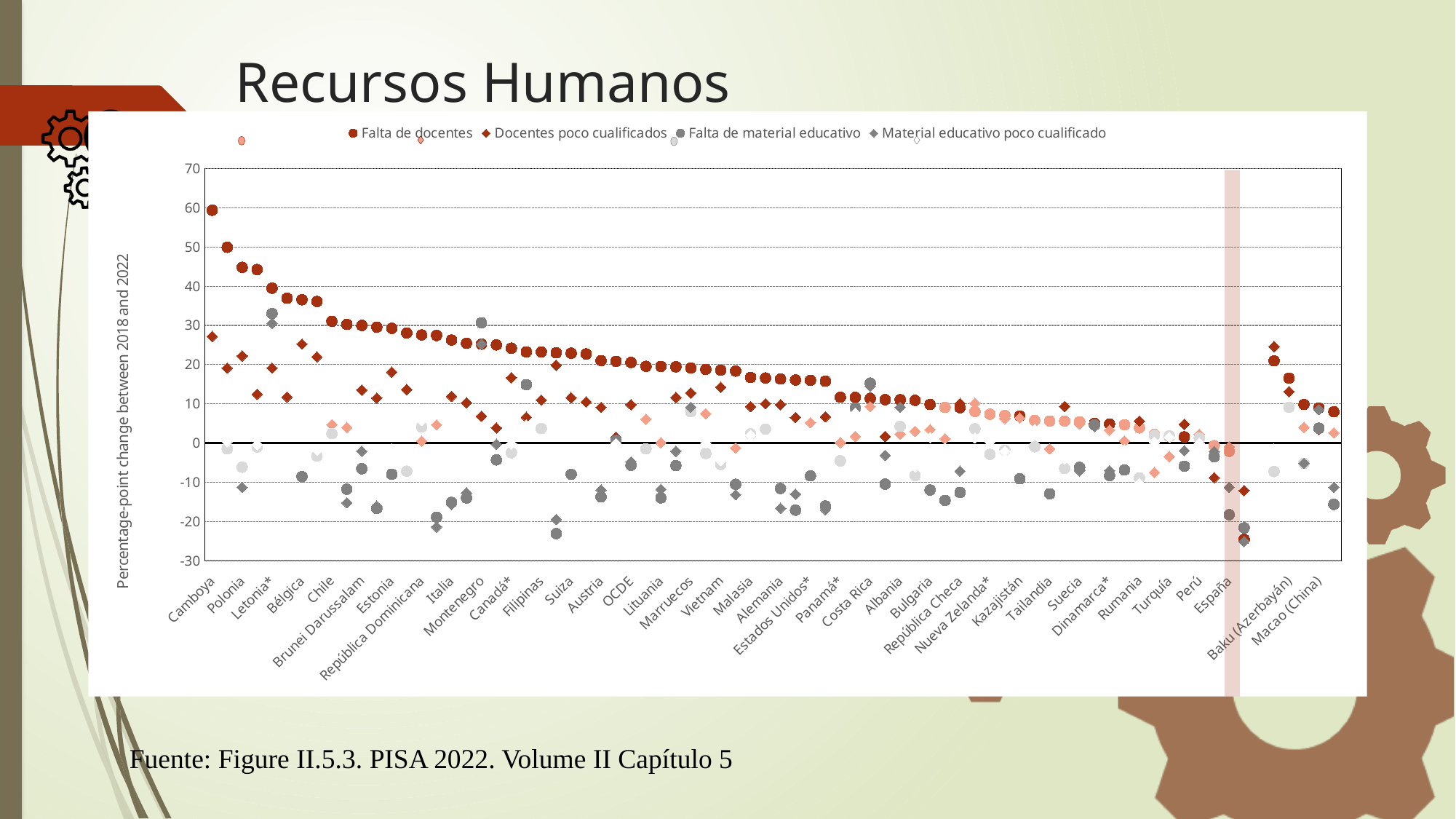
Which category has the highest value for the 'Falta de docentes' series? Camboya Is the 'Falta de docentes' value for España greater or less than 0? less Is the 'Falta de docentes' value for Camboya greater or less than 50? greater What kind of chart is shown on the slide? Scatter (dot) chart Is the 'Falta de docentes' value for Bélgica greater or less than 40? less Do the 'Falta de docentes' values rise or fall from left to right along the x axis? fall How many series does the chart legend list? 4 Which has the larger 'Falta de docentes' value, Camboya or Polonia? Camboya What is the label of the vertical axis of the chart? Percentage-point change between 2018 and 2022